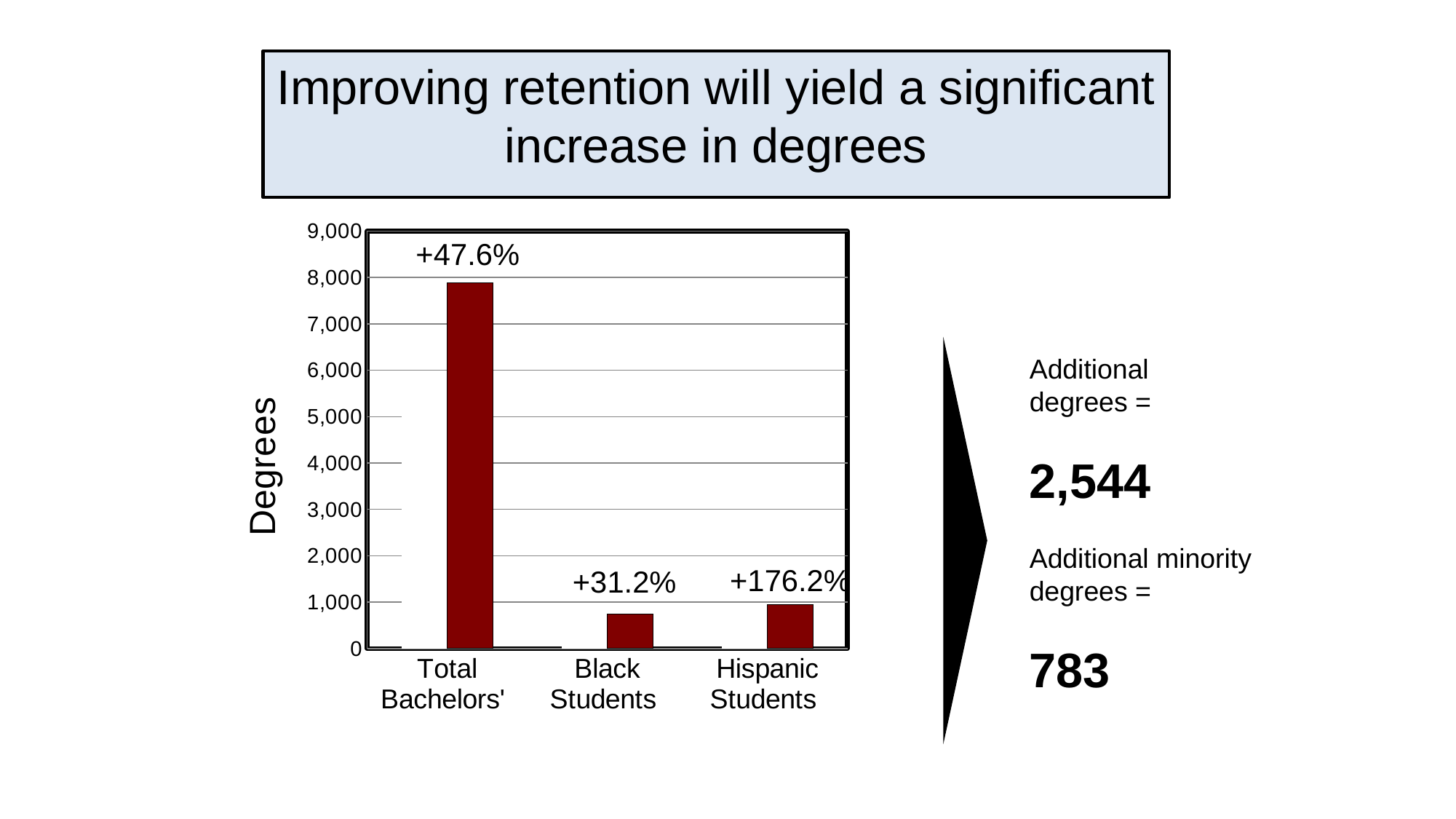
Is the value for Black Students greater or less than 1,000? less Is the value for Hispanic Students greater or less than 2,000? less Which category has the highest bar in the chart? Total Bachelors' What percentage label is shown above the Black Students bar? +31.2% Which bar is taller, Black Students or Hispanic Students? Hispanic Students What is the title of the y axis of the chart? Degrees Which category has the lowest bar in the chart? Black Students What percentage label is shown above the Total Bachelors' bar? +47.6% What kind of chart is shown on the slide? bar chart What percentage label is shown above the Hispanic Students bar? +176.2% How many categories are shown on the x axis of the chart? 3 Is the value for Total Bachelors' greater or less than 7,000? greater